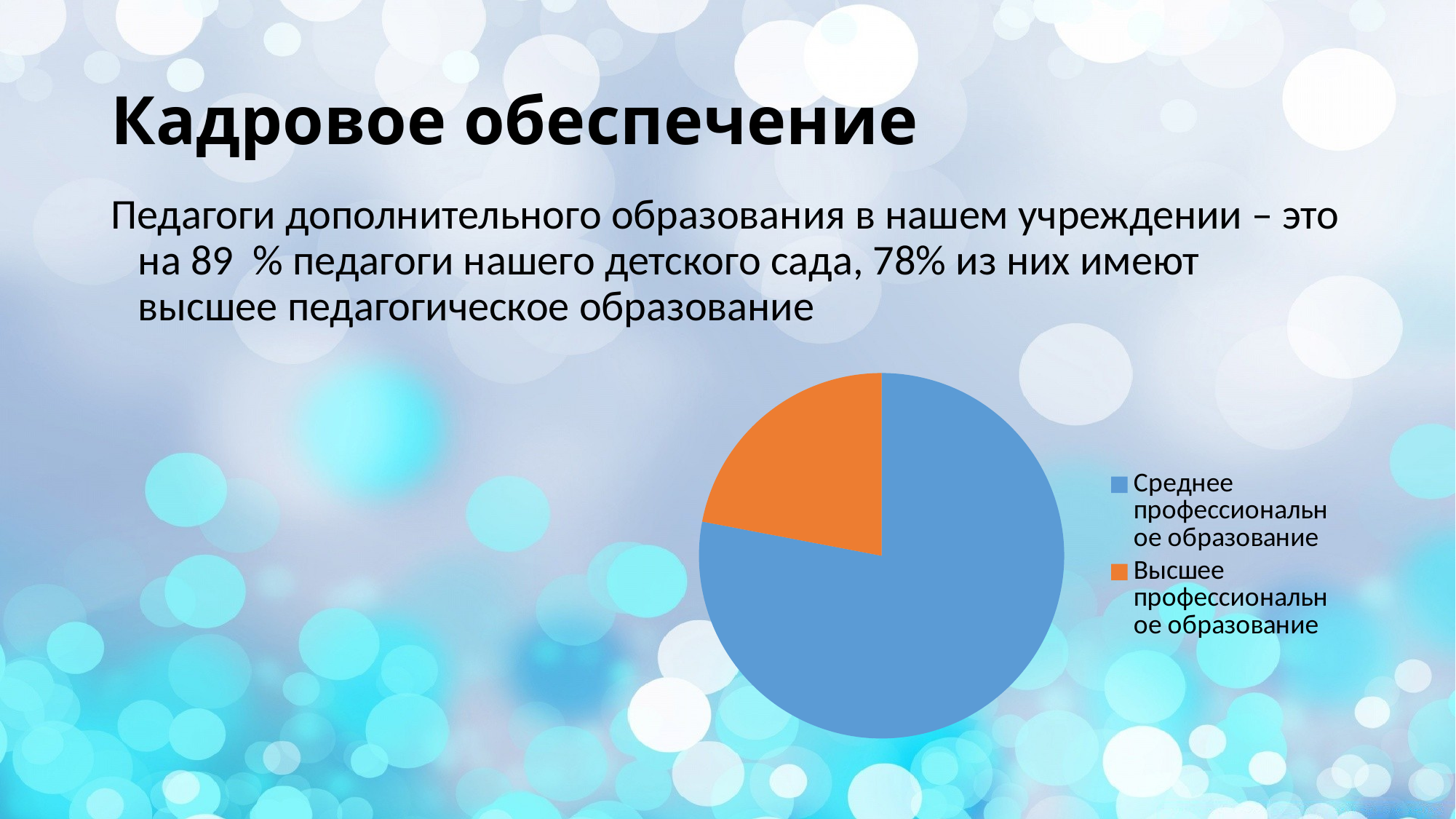
What colour is the slice for Среднее профессиональное образование? blue How many entries does the legend of the pie chart list? 2 Which category has the largest slice in the pie chart? Среднее профессиональное образование What colour is the slice for Высшее профессиональное образование? orange Which slice is larger: Среднее профессиональное образование or Высшее профессиональное образование? Среднее профессиональное образование What kind of chart is shown on the slide? pie chart Which category has the smallest slice in the pie chart? Высшее профессиональное образование How many slices does the pie chart have? 2 Does the slice for Среднее профессиональное образование take up more or less than half of the pie? more